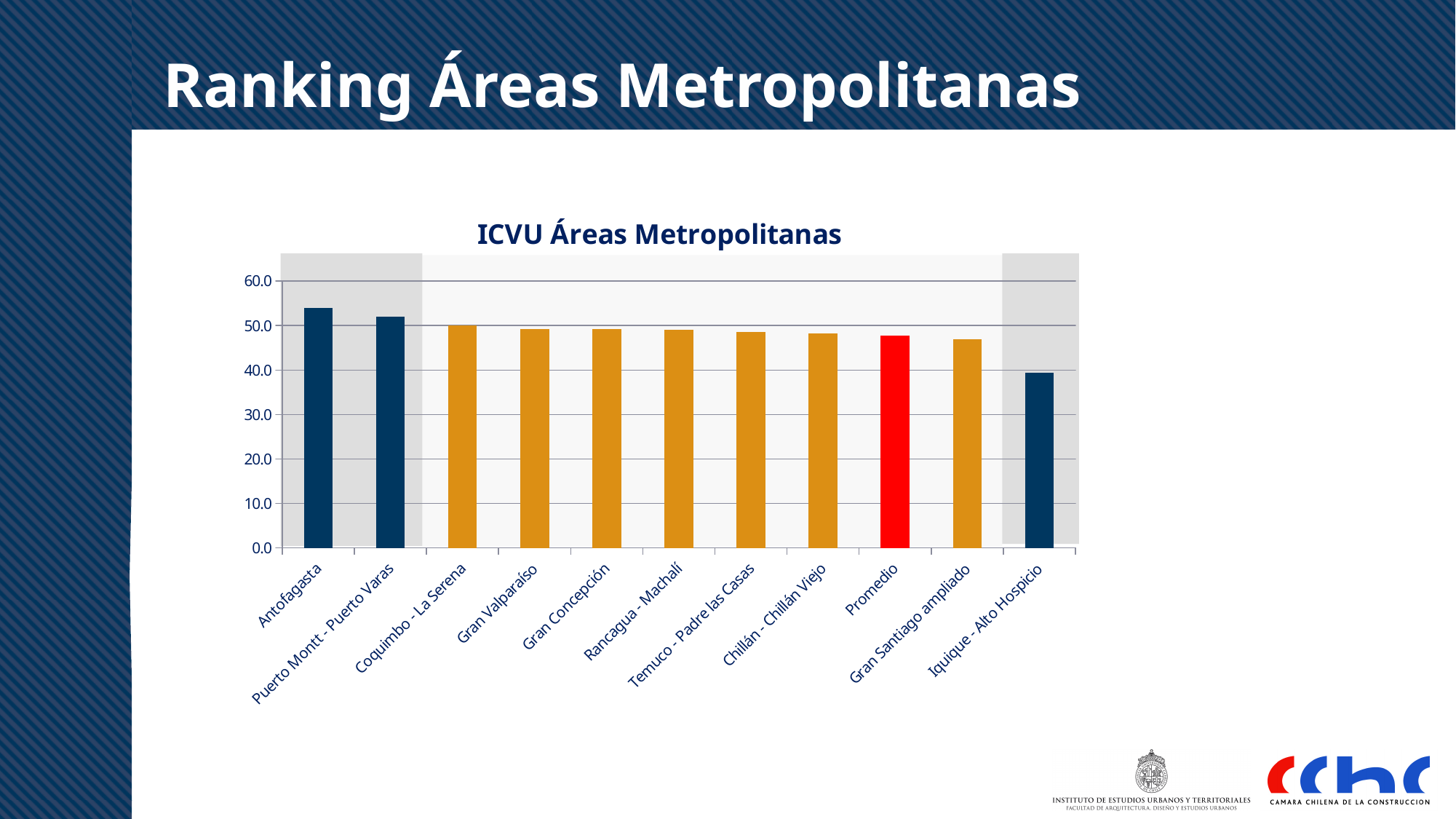
What kind of chart is shown on the slide? bar chart How many categories are shown on the x axis of the chart? 11 Which category's bar is coloured red in the chart? Promedio Is the value for Antofagasta greater or less than 50.0? greater Which category has the lowest value in the chart? Iquique - Alto Hospicio Is the value for Gran Santiago ampliado greater or less than 50.0? less Which is larger, the value for Antofagasta or the value for Iquique - Alto Hospicio? Antofagasta Is the value for Puerto Montt - Puerto Varas greater or less than 50.0? greater Do the values generally rise or fall from left to right along the x axis? fall Which category has the highest value in the chart? Antofagasta What is the title of the chart? ICVU Áreas Metropolitanas